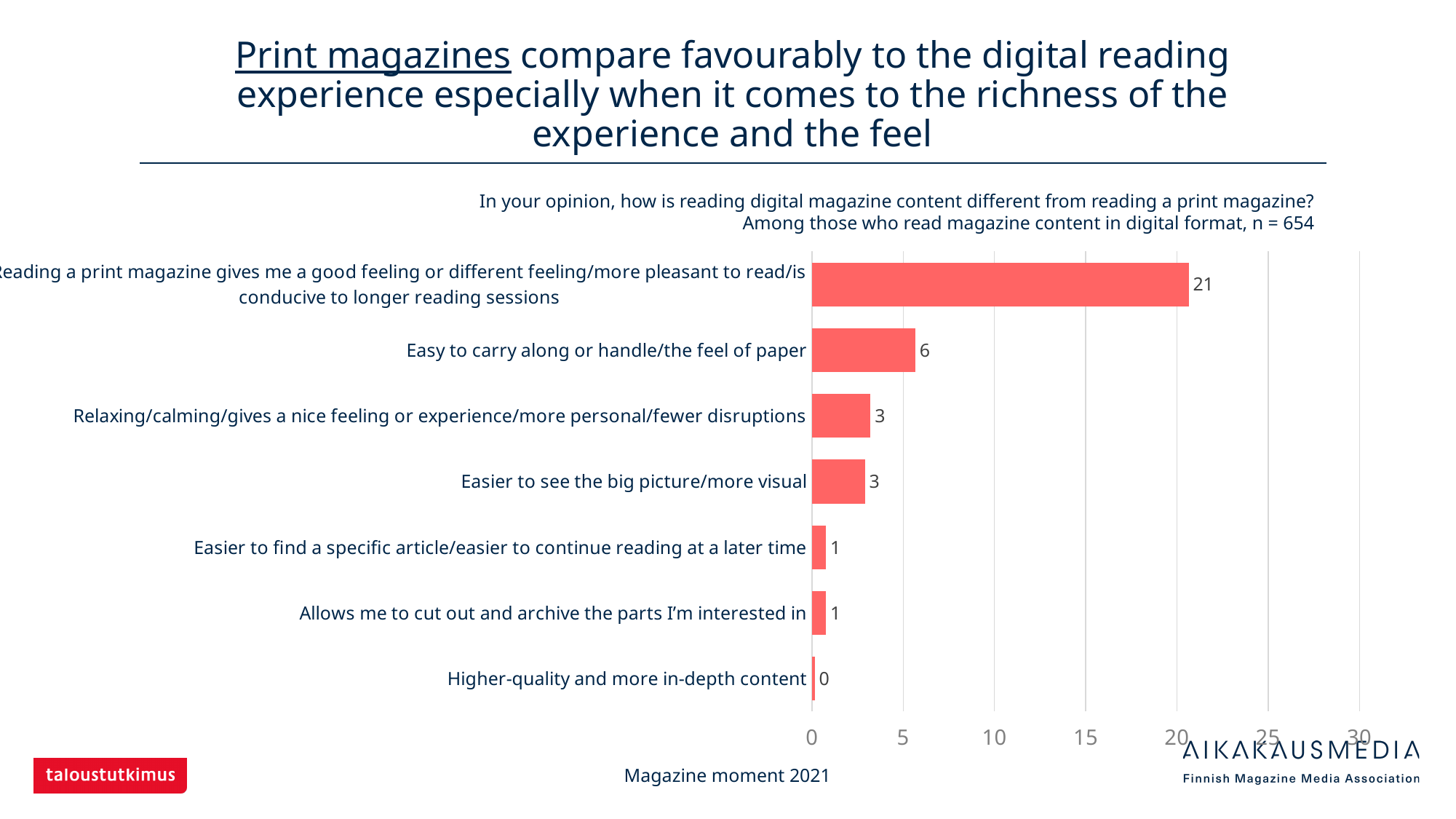
What is the sample size (n) stated in the chart subtitle? 654 Is the value for "Reading a print magazine gives me a good feeling..." greater or less than 20? greater What is the value for "Higher-quality and more in-depth content"? 0 Which category has the lowest value? Higher-quality and more in-depth content Which is larger: the value for "Easy to carry along or handle/the feel of paper" or the value for "Relaxing/calming/gives a nice feeling or experience/more personal/fewer disruptions"? Easy to carry along or handle/the feel of paper What is the value for "Easier to see the big picture/more visual"? 3 How many categories are shown in the chart? 7 What kind of chart is shown on the slide? bar chart What is the value for "Allows me to cut out and archive the parts I'm interested in"? 1 What is the difference between the value for "Reading a print magazine gives me a good feeling..." and the value for "Easy to carry along or handle/the feel of paper"? 15 What is the value for "Easy to carry along or handle/the feel of paper"? 6 Which category has the highest value? Reading a print magazine gives me a good feeling or different feeling/more pleasant to read/is conducive to longer reading sessions